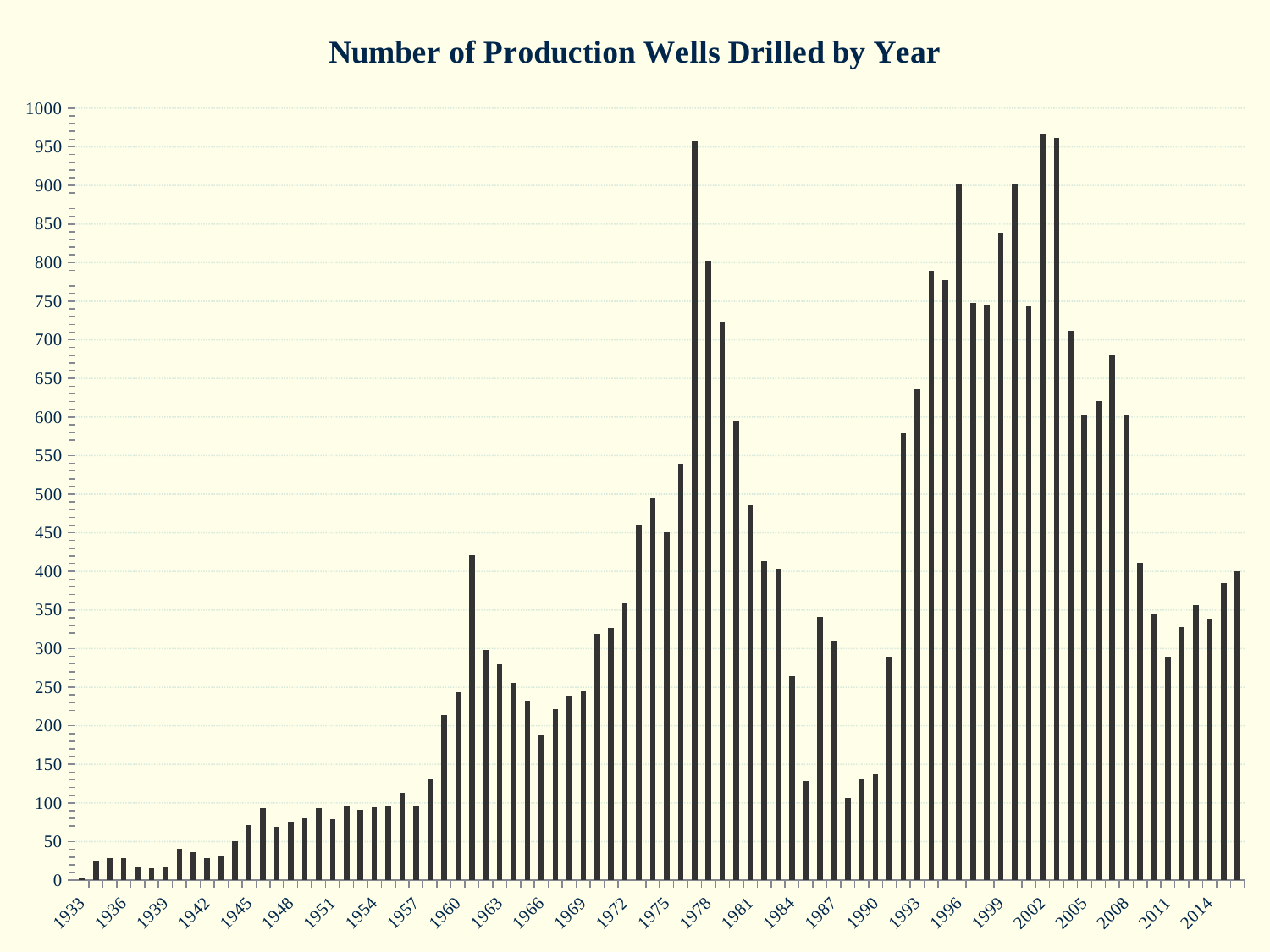
Is the value for 1990 greater or less than 150? less Do the values generally rise or fall from 1933 to 1945? rise Which year has the lowest number of production wells drilled? 1933 Which year has the larger value, 1977 or 1984? 1977 Which year has the larger value, 1993 or 1987? 1993 What is the title of the chart? Number of Production Wells Drilled by Year Is the value for 1977 greater or less than 900? greater Is the value for 1960 greater or less than 400? less Do the values generally rise or fall from 2002 to 2011? fall What kind of chart is shown on the slide? bar chart